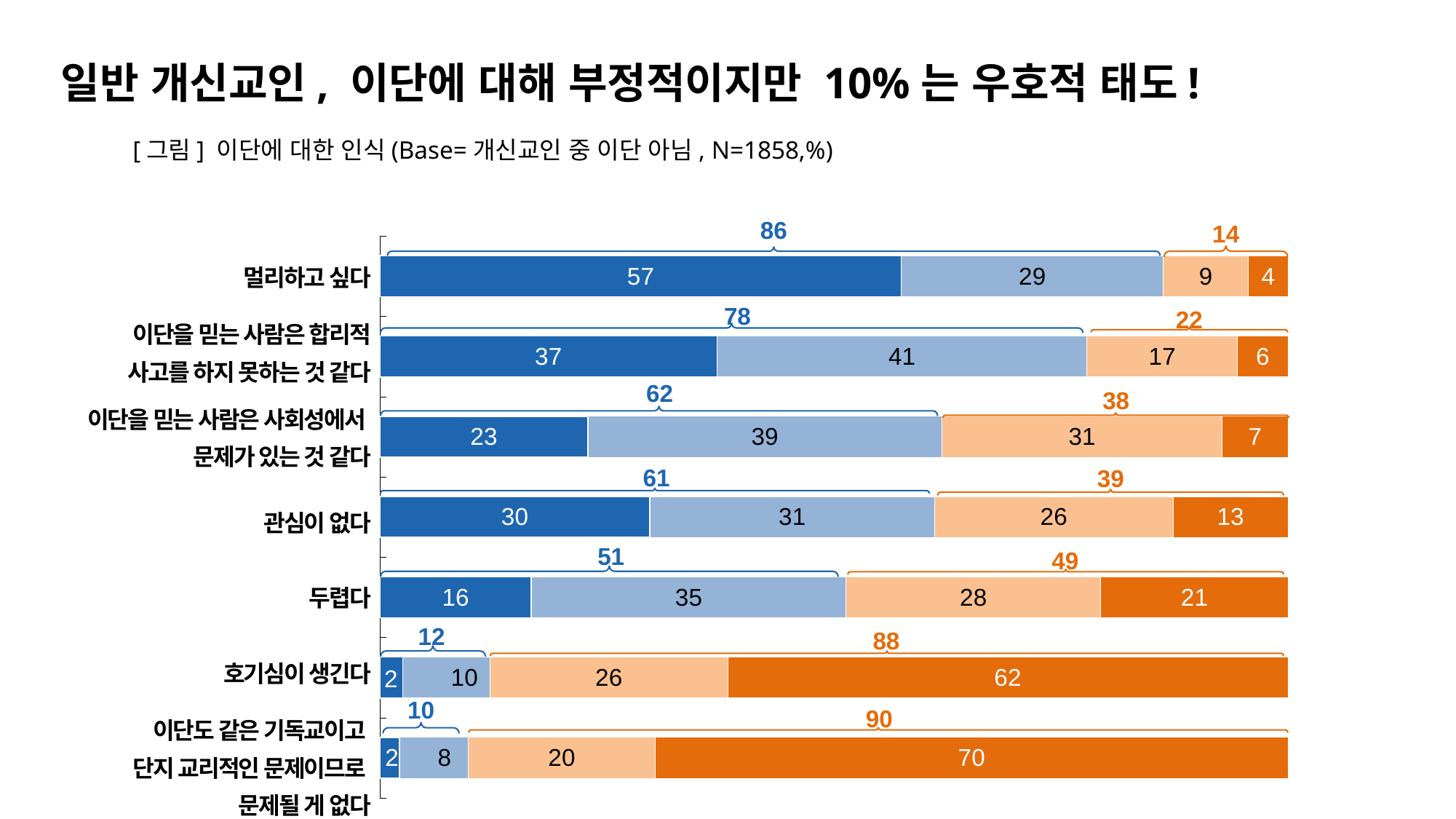
What is the total of the four segments for 관심이 없다? 100 What is the difference between the dark blue segment (57) and the light blue segment (29) for 멀리하고 싶다? 28 What is the value of the dark blue segment for 멀리하고 싶다? 57 What kind of chart is shown on the slide? Stacked bar chart Which category has the largest dark blue segment? 멀리하고 싶다 What is the N (base size) stated in the chart caption? 1858 What is the value of the light orange segment for 이단을 믿는 사람은 사회성에서 문제가 있는 것 같다? 31 Which has a larger dark orange segment, 두렵다 or 관심이 없다? 두렵다 How many categories are shown in the chart? 7 What is the value of the dark orange segment for 호기심이 생긴다? 62 Which category has the smallest dark orange segment? 멀리하고 싶다 What is the orange bracket total shown above the bar for 이단도 같은 기독교이고 단지 교리적인 문제이므로 문제될 게 없다? 90